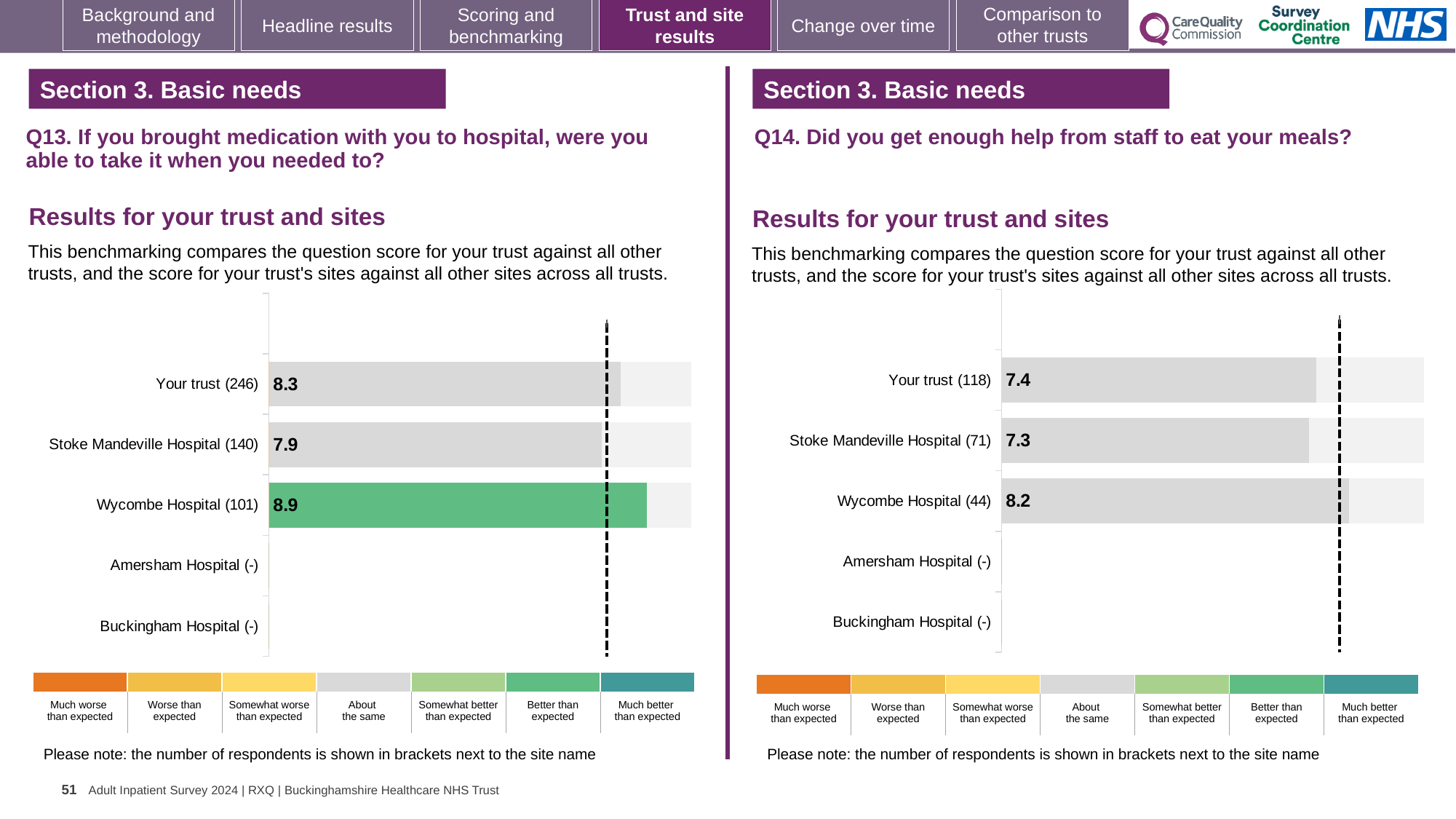
On the Q13 chart (left), what is the difference between the scores for Wycombe Hospital and Stoke Mandeville Hospital? 1.0 On the Q14 chart (right), which is larger: the score for Wycombe Hospital or the score for Stoke Mandeville Hospital? Wycombe Hospital On the Q13 chart (left), which site has the highest score? Wycombe Hospital On the Q14 chart (right), what is the difference between the scores for Wycombe Hospital and Your trust? 0.8 What kind of chart is used on the Q13 chart (left)? Bar chart On the Q13 chart (left), how many respondents are shown for Stoke Mandeville Hospital? 140 On the Q13 chart (left), which site's bar is coloured green, indicating 'Better than expected'? Wycombe Hospital On the Q14 chart (right), which site has the highest score? Wycombe Hospital On the Q14 chart (right), what is the score for Stoke Mandeville Hospital? 7.3 On the Q14 chart (right), what is the score for Your trust? 7.4 On the Q13 chart (left), what is the score for Your trust? 8.3 On the Q13 chart (left), what is the score for Wycombe Hospital? 8.9